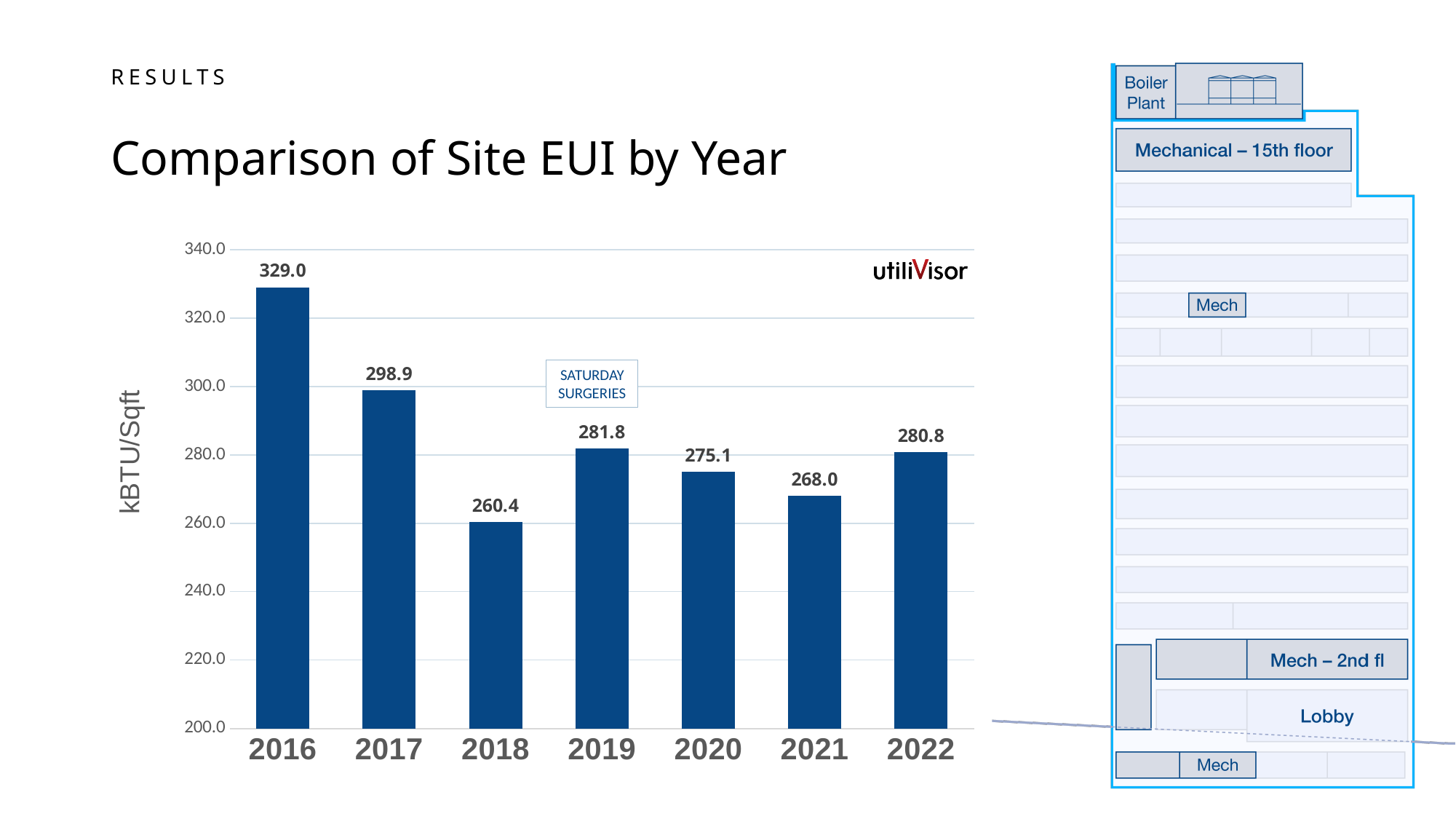
What is the Site EUI value for 2022? 280.8 Which year has the highest Site EUI? 2016 What is the difference between the Site EUI values for 2019 and 2021? 13.8 What is the difference between the Site EUI values for 2016 and 2017? 30.1 What type of chart is shown on the slide? bar chart Which year has a higher Site EUI, 2020 or 2021? 2020 Which year has the lowest Site EUI? 2018 Is the value for 2017 greater or less than 300.0? less What is the label on the vertical axis of the chart? kBTU/Sqft How many years are shown on the chart? 7 What is the Site EUI value for 2018? 260.4 What is the Site EUI value for 2016? 329.0